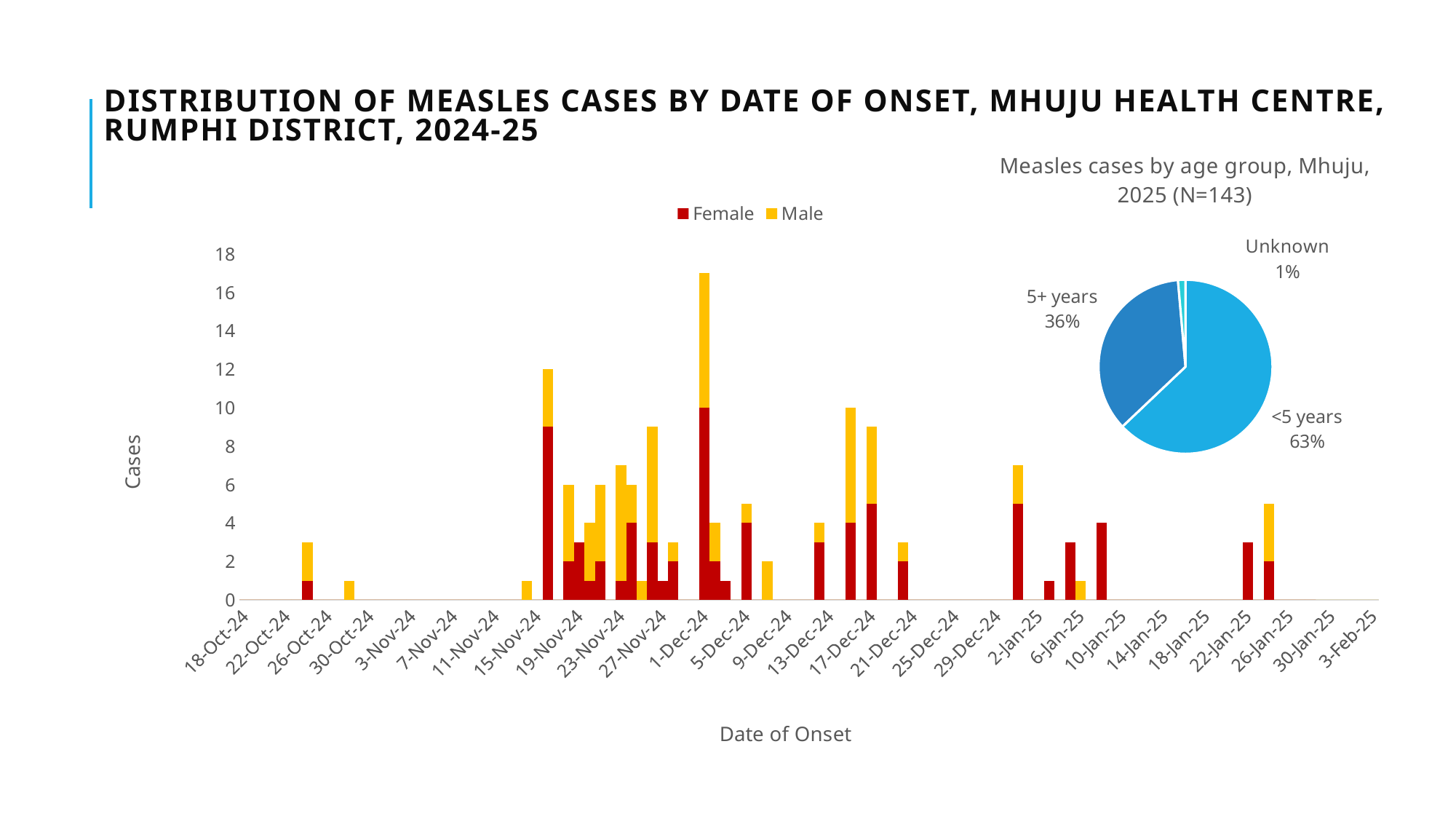
In the pie chart 'Measles cases by age group, Mhuju, 2025 (N=143)', what percentage of cases is in the 5+ years group? 36% In the pie chart 'Measles cases by age group, Mhuju, 2025 (N=143)', how many percentage points larger is the <5 years share than the 5+ years share? 27 percentage points What kind of chart is the 'Distribution of measles cases by date of onset' chart on the left? Stacked bar chart In the pie chart 'Measles cases by age group, Mhuju, 2025 (N=143)', which age group has the largest share of cases? <5 years In the pie chart 'Measles cases by age group, Mhuju, 2025 (N=143)', what percentage of cases has an unknown age group? 1% In the pie chart 'Measles cases by age group, Mhuju, 2025 (N=143)', what share of cases is in the <5 years group? 63% In the 'Distribution of measles cases by date of onset' chart, which colour represents Female cases? Red How many slices does the pie chart 'Measles cases by age group, Mhuju, 2025 (N=143)' have? 3 How many series does the legend of the 'Distribution of measles cases by date of onset' chart list? 2 What is the total number of cases (N) stated in the title of the pie chart on the right? 143 In the 'Distribution of measles cases by date of onset' chart, is the tallest bar greater or less than 16 cases? greater In the pie chart 'Measles cases by age group, Mhuju, 2025 (N=143)', which age group has the smallest share of cases? Unknown